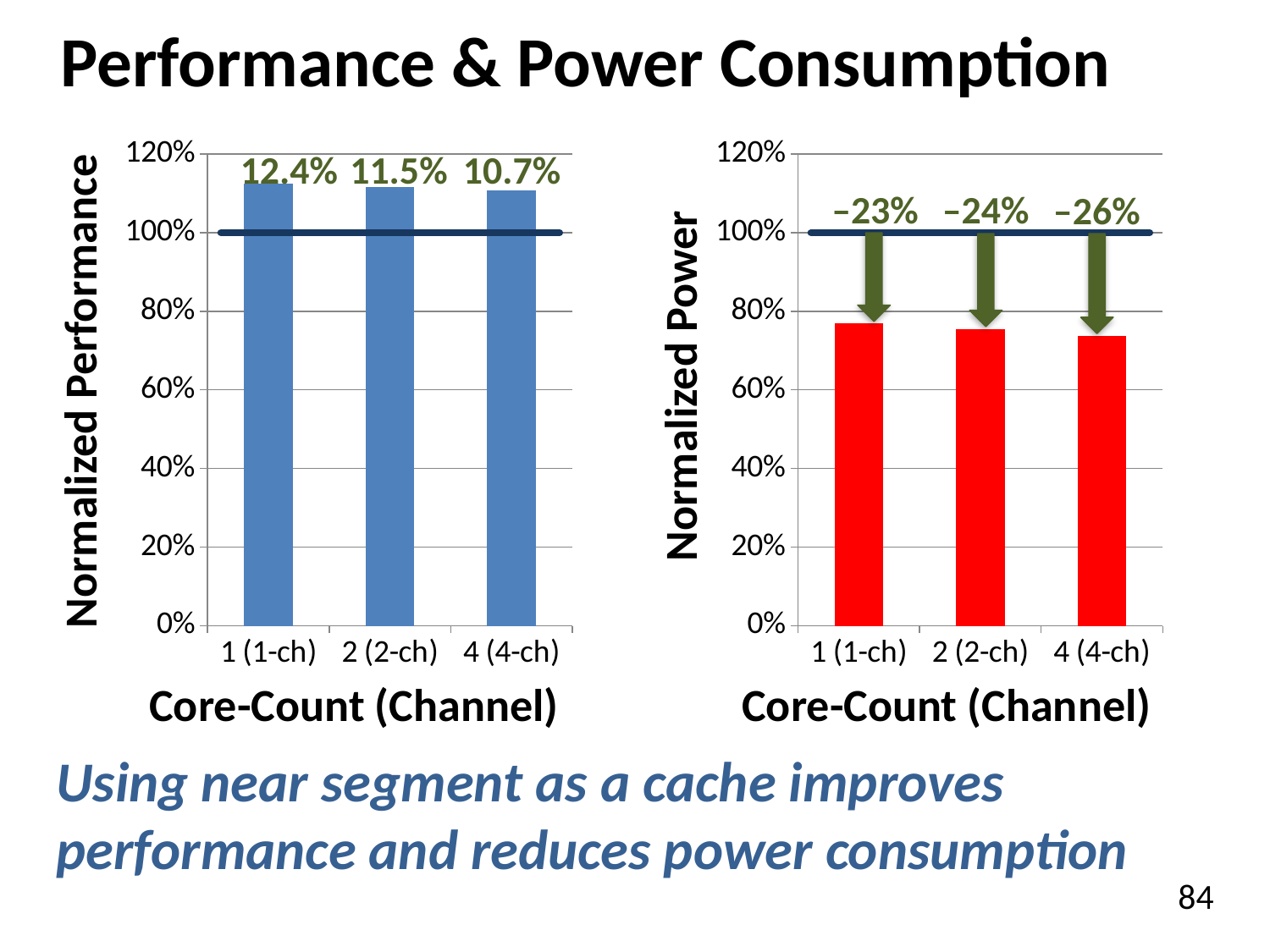
On the Normalized Performance chart (left), what improvement is labeled above the bar for 4 (4-ch)? 10.7% On the Normalized Performance chart (left), is the bar for 2 (2-ch) greater or less than 100%? greater On the Normalized Power chart (right), what power reduction is labeled for 2 (2-ch)? –24% What kind of chart is the Normalized Performance chart on the left? Bar chart On the Normalized Power chart (right), what power reduction is labeled for 4 (4-ch)? –26% On the Normalized Power chart (right), do the bar values rise or fall as the core count increases from 1 to 4? Fall On the Normalized Power chart (right), is the bar for 1 (1-ch) greater or less than 80%? less What is the x-axis title of the Normalized Performance chart (left)? Core-Count (Channel) How many core-count configurations are shown on the Normalized Power chart (right)? 3 On the Normalized Performance chart (left), what performance improvement is labeled above the bar for 1 (1-ch)? 12.4% On the Normalized Performance chart (left), which core-count configuration has the highest normalized performance? 1 (1-ch) On the Normalized Power chart (right), which core-count configuration has the lowest normalized power? 4 (4-ch)